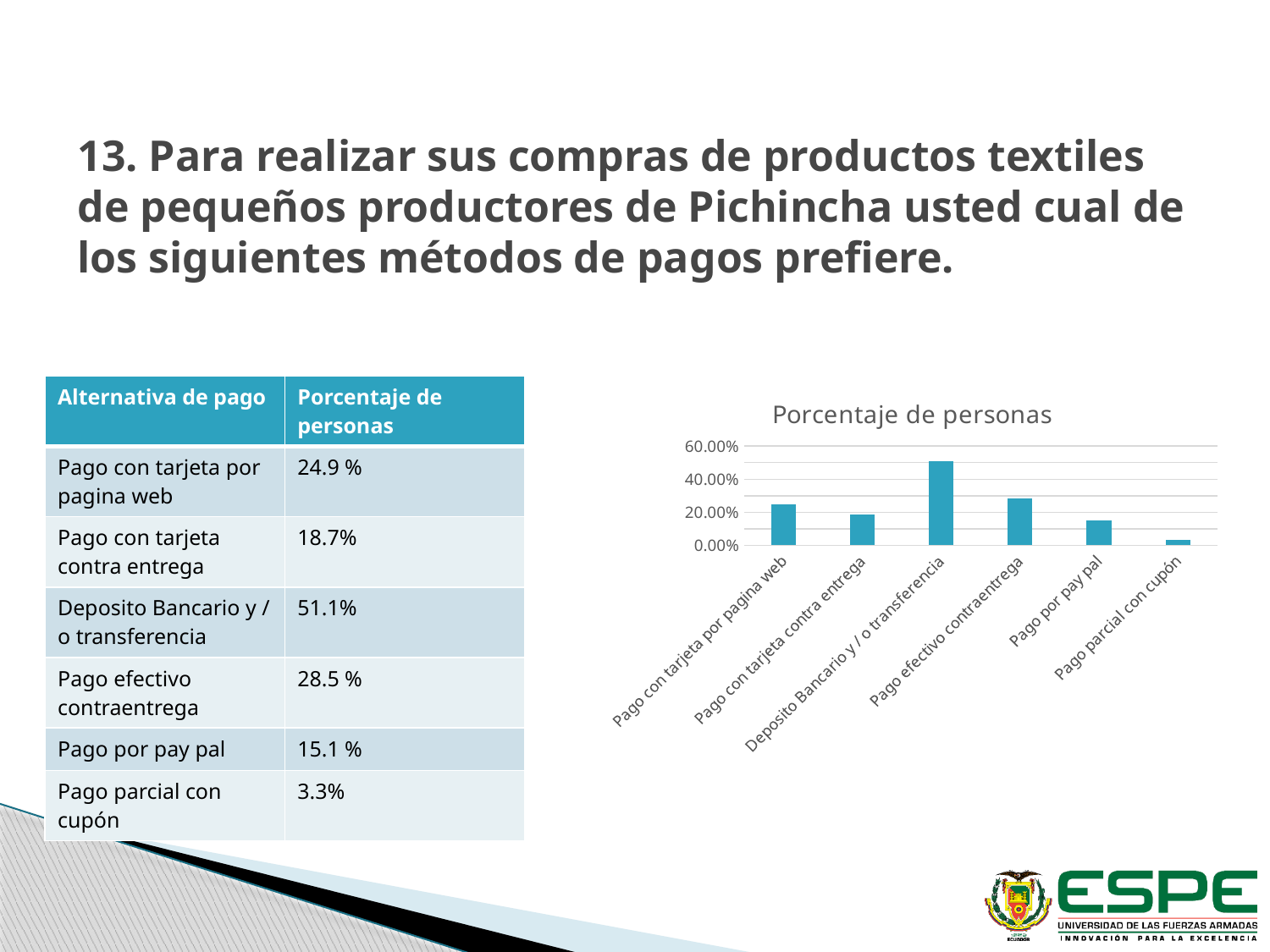
According to the slide, what percentage of people prefer Deposito Bancario y / o transferencia? 51.1% What is the title of the chart? Porcentaje de personas Is the value for Pago efectivo contraentrega greater or less than 20.00%? greater Which payment alternative has the highest bar in the chart? Deposito Bancario y / o transferencia What is the difference between the percentage for Deposito Bancario y / o transferencia and the percentage for Pago efectivo contraentrega? 22.6% According to the slide, what percentage of people prefer Pago efectivo contraentrega? 28.5 % How many payment alternatives (categories) are plotted in the chart? 6 Is the value for Pago parcial con cupón greater or less than 20.00%? less Is the value for Deposito Bancario y / o transferencia greater or less than 40.00%? greater What kind of chart is shown on the slide? bar chart Which payment alternative has the lowest bar in the chart? Pago parcial con cupón Which is larger, the value for Pago con tarjeta por pagina web or the value for Pago por pay pal? Pago con tarjeta por pagina web